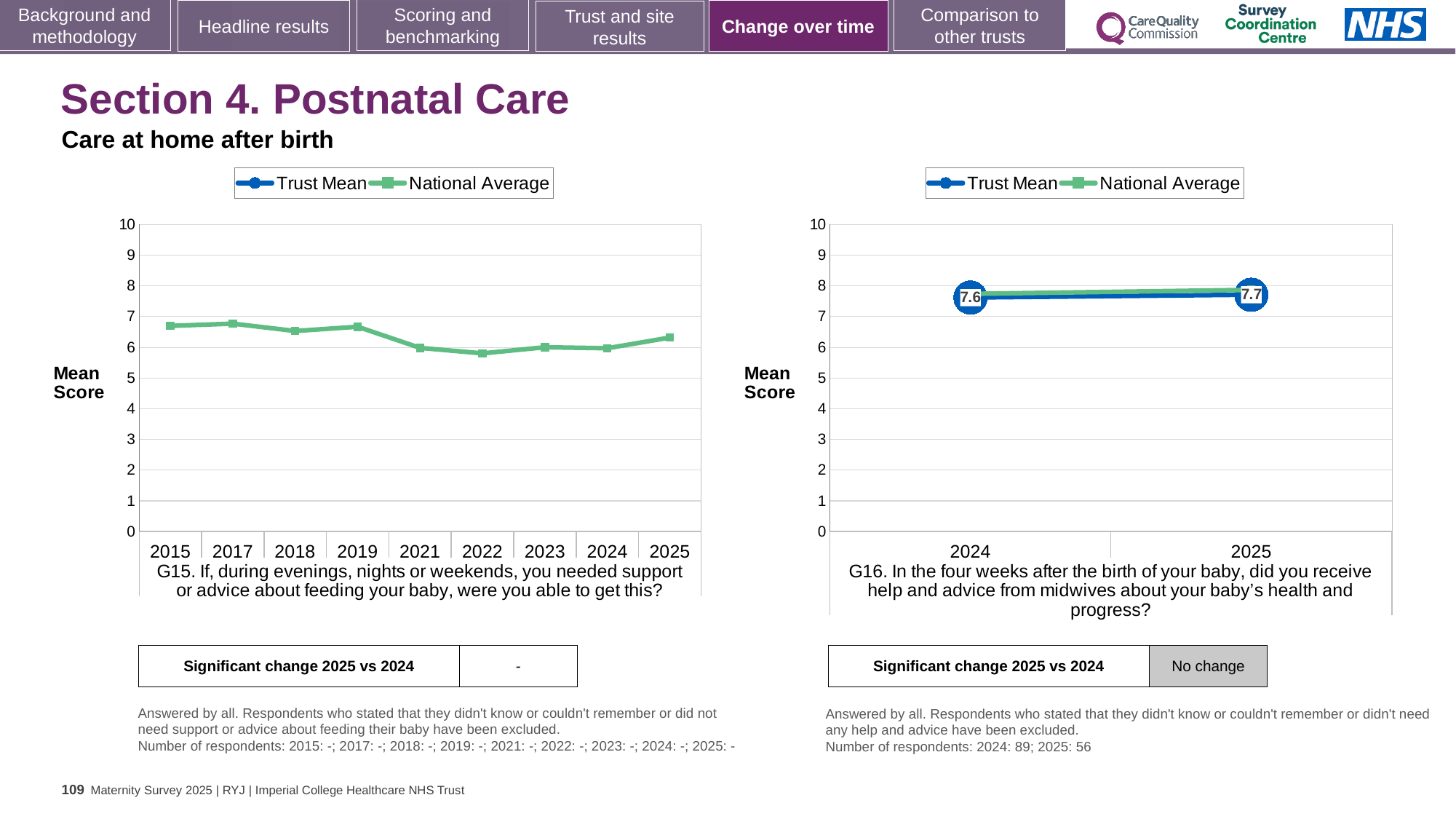
On the right chart (G16), what is the difference between the Trust Mean scores for 2025 and 2024? 0.1 On the right chart (G16), which year has the higher Trust Mean score, 2024 or 2025? 2025 On the right chart (G16), how many years are shown on the x axis? 2 On the left chart (G15), how many series does the legend list? 2 On the left chart (G15), does the National Average rise or fall from 2015 to 2022? fall On the right chart (G16), what is the Trust Mean score for 2025? 7.7 What kind of chart is the left chart (G15)? line chart On the right chart (G16), does the Trust Mean rise or fall from 2024 to 2025? rise On the right chart (G16), is the Trust Mean value for 2024 greater or less than 7? greater On the right chart (G16), what is the Trust Mean score for 2024? 7.6 On the left chart (G15), how many years are shown on the x axis? 9 On the left chart (G15), is the National Average value for 2015 greater or less than 6? greater